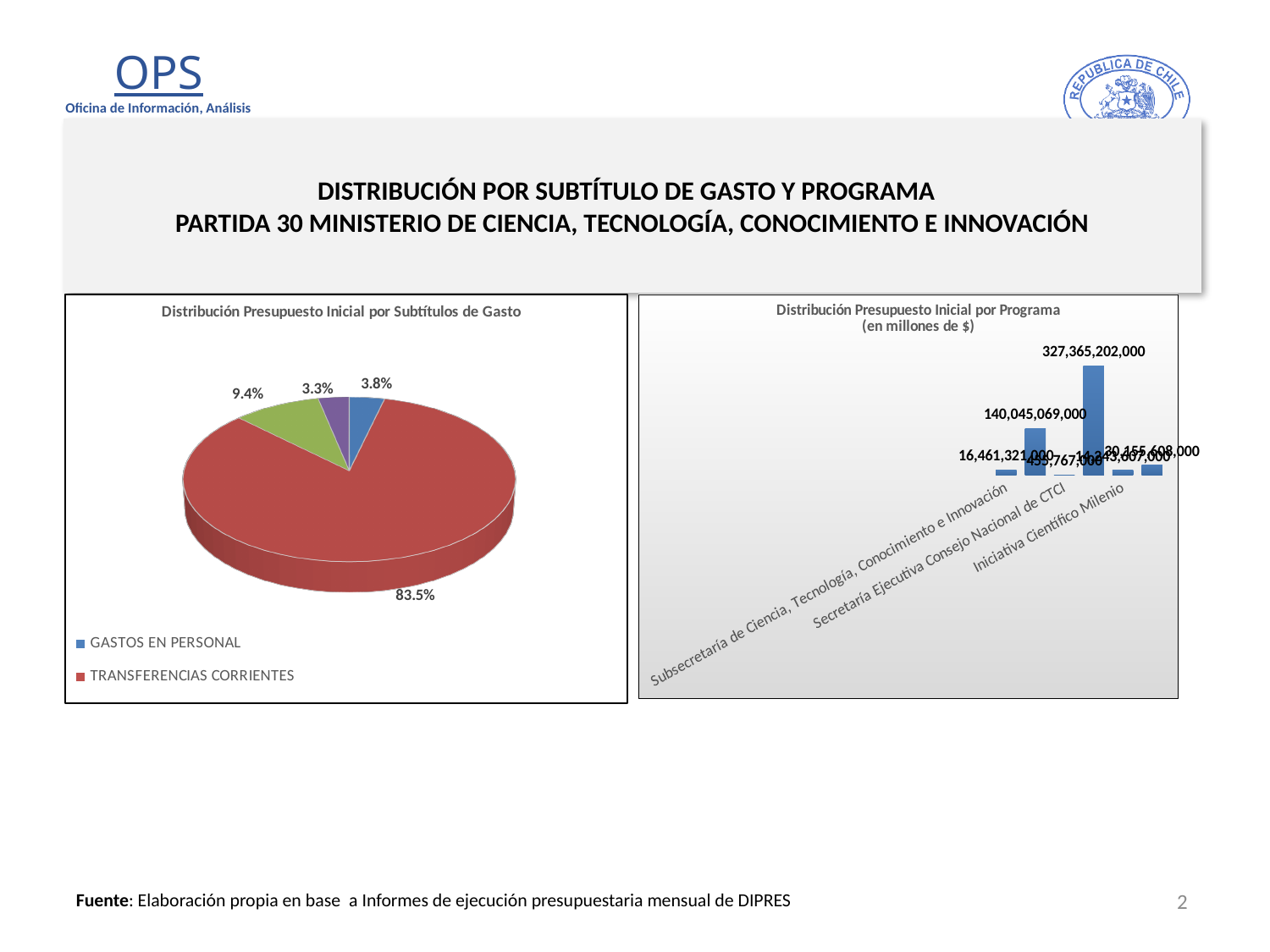
In the pie chart 'Distribución Presupuesto Inicial por Subtítulos de Gasto', what percentage is shown for TRANSFERENCIAS CORRIENTES? 83.5% In the bar chart 'Distribución Presupuesto Inicial por Programa', how many bars are plotted? 6 What kind of chart is 'Distribución Presupuesto Inicial por Programa'? Bar chart In the pie chart on the left, how many entries does the legend list? 2 In the pie chart 'Distribución Presupuesto Inicial por Subtítulos de Gasto', what percentage is shown for GASTOS EN PERSONAL? 3.8% In the pie chart on the left, which is larger: the 9.4% slice or the 3.3% slice? 9.4% What kind of chart is the chart on the left of the slide? Pie chart What unit is stated in the subtitle of the bar chart on the right? en millones de $ In the pie chart on the left, what is the difference in percentage points between TRANSFERENCIAS CORRIENTES and GASTOS EN PERSONAL? 79.7 In the pie chart on the left, which legend category has the largest slice? TRANSFERENCIAS CORRIENTES In the bar chart 'Distribución Presupuesto Inicial por Programa', what is the value of the tallest bar? 327,365,202,000 In the pie chart on the left, how many slices does the pie have? 4